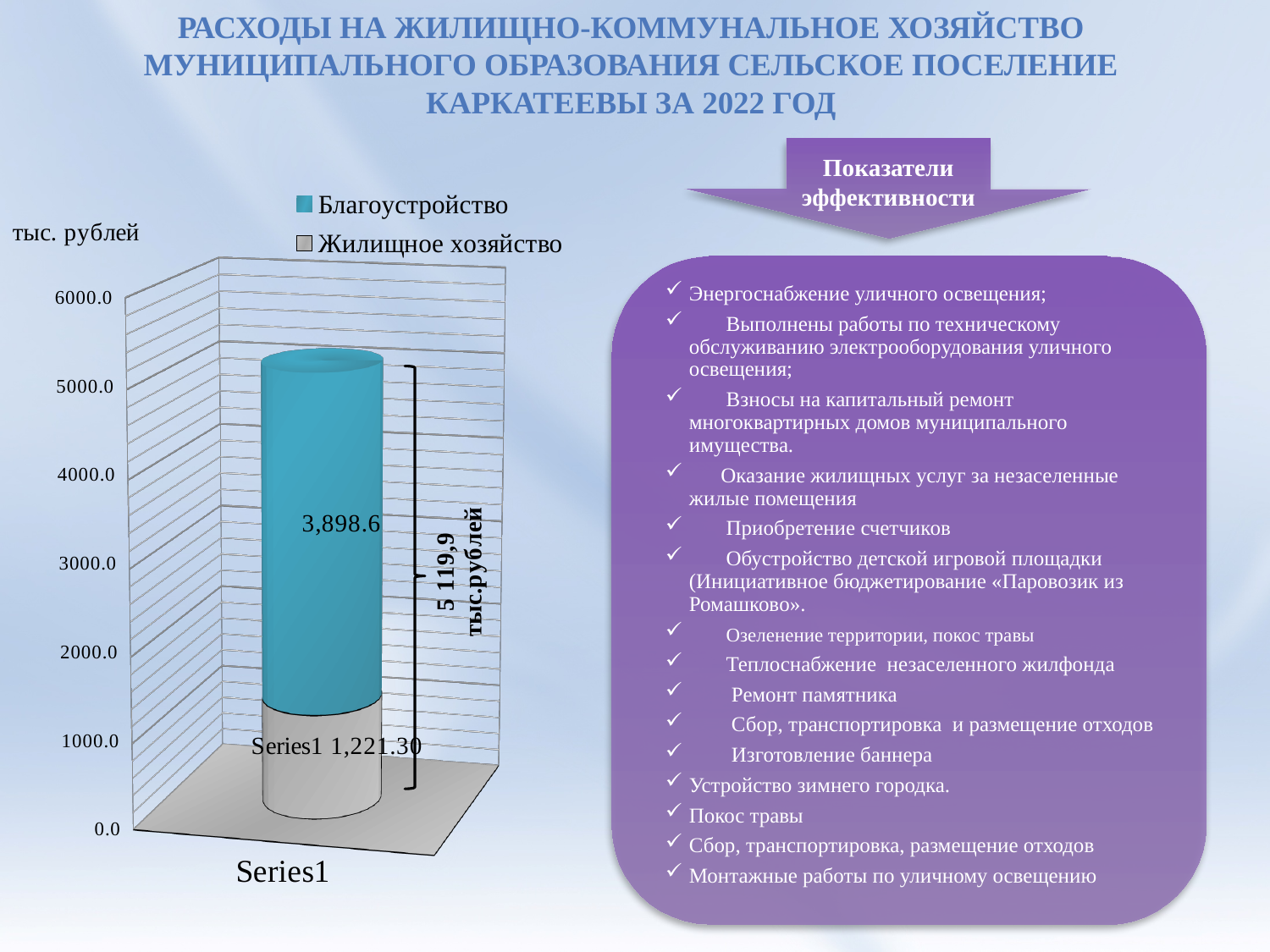
What total is shown for the stacked bar by the bracket annotation? 5 119,9 тыс.рублей What is the difference between the Благоустройство value and the Жилищное хозяйство value? 2,677.3 How many categories are plotted on the x axis? 1 How many series does the legend list? 2 What is the value of the Жилищное хозяйство segment in the stacked bar? 1,221.30 What unit label is shown above the vertical axis of the chart? тыс. рублей Is the total height of the stacked bar greater or less than 5000.0? greater Which series is shown in blue in the legend? Благоустройство What kind of chart is shown on the slide? Stacked bar chart What is the value of the Благоустройство segment in the stacked bar? 3,898.6 Is the Жилищное хозяйство segment greater or less than 2000.0? less Which series has the larger value, Благоустройство or Жилищное хозяйство? Благоустройство